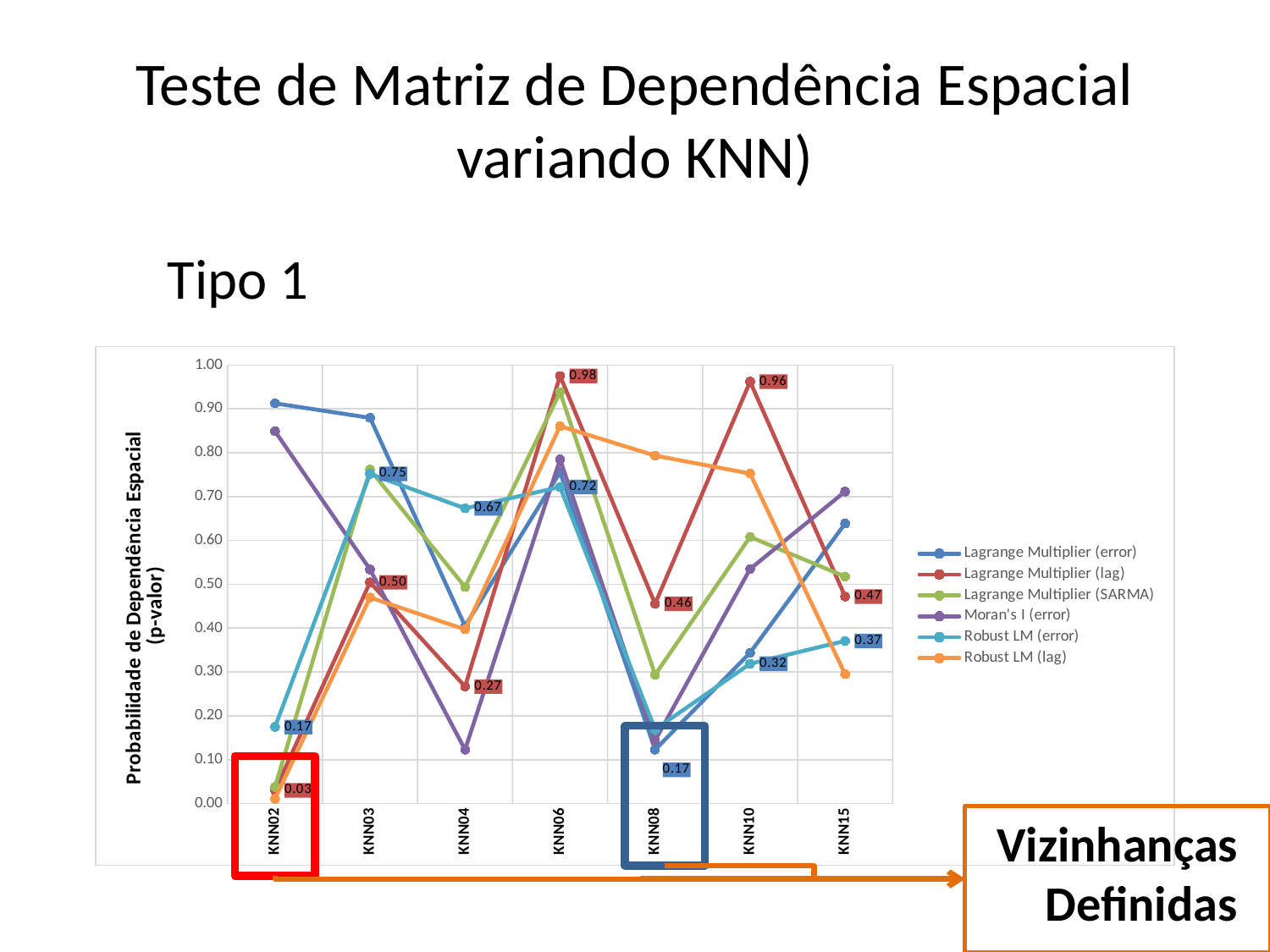
Is the value for Lagrange Multiplier (error) at KNN02 greater or less than 0.80? greater What is the value of Lagrange Multiplier (lag) at KNN02? 0.03 What is the difference between the Lagrange Multiplier (lag) values at KNN06 and KNN10? 0.02 What is the value of Robust LM (error) at KNN03? 0.75 What type of chart is shown on the slide? line chart How many series does the legend list? 6 At which KNN category does Lagrange Multiplier (lag) have its lowest value? KNN02 What is the title of the y axis? Probabilidade de Dependência Espacial (p-valor) At KNN06, which is larger: Lagrange Multiplier (lag) or Robust LM (error)? Lagrange Multiplier (lag) How many KNN categories are shown on the x axis? 7 At which KNN category does Lagrange Multiplier (lag) reach its highest value? KNN06 What is the value of Lagrange Multiplier (lag) at KNN06? 0.98